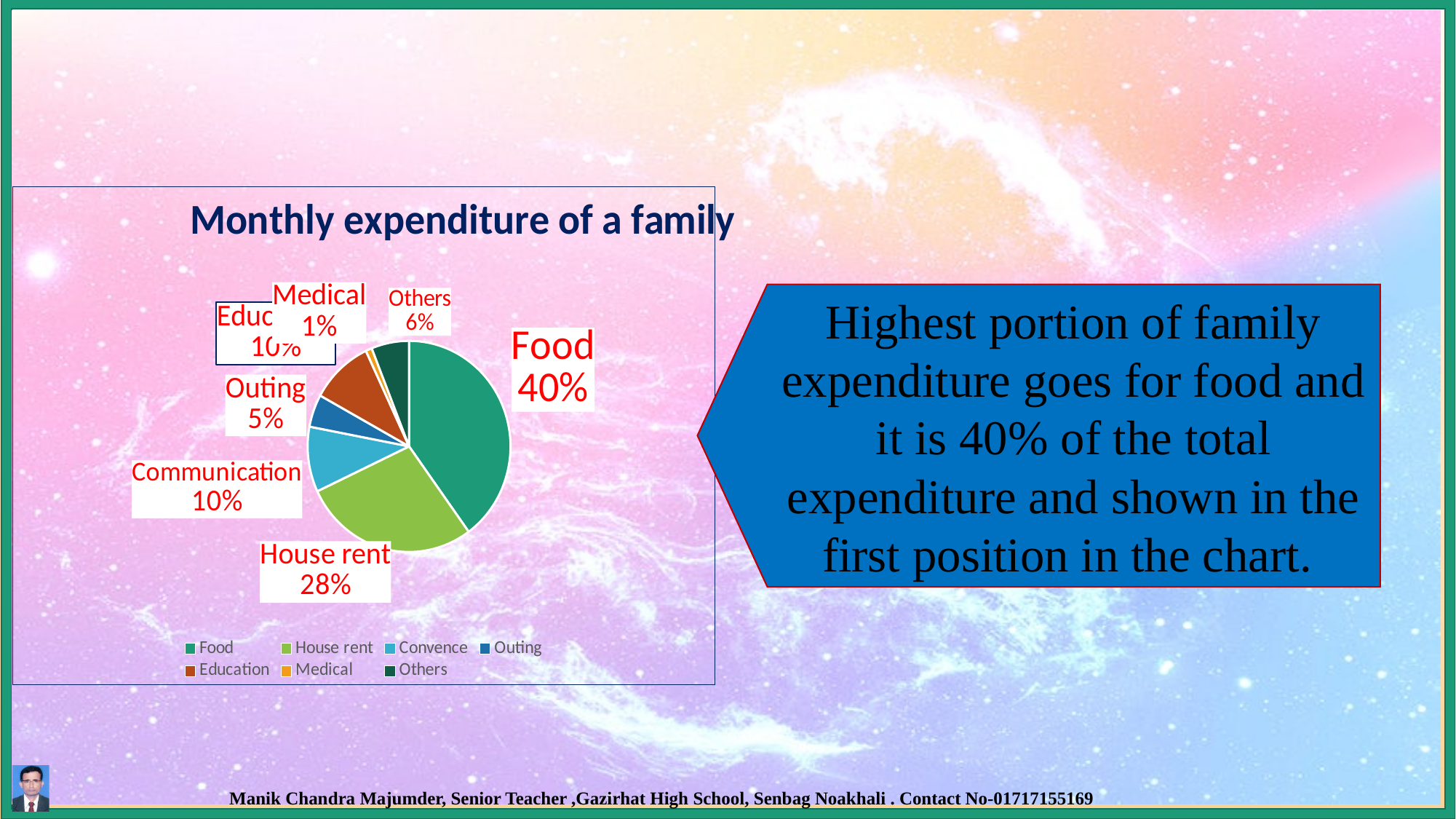
What percentage of the monthly expenditure goes to Others? 6% What percentage of the monthly expenditure goes to Communication? 10% What percentage of the monthly expenditure goes to Medical? 1% What type of chart is shown on the slide? Pie chart What percentage of the monthly expenditure goes to House rent? 28% What percentage of the monthly expenditure goes to Outing? 5% Which category has the smallest share of the monthly expenditure? Medical How many entries does the legend list? 7 What percentage of the monthly expenditure goes to Food? 40% Which category has the largest share of the monthly expenditure? Food What is the title of the chart? Monthly expenditure of a family What is the difference in percentage points between Food and House rent? 12